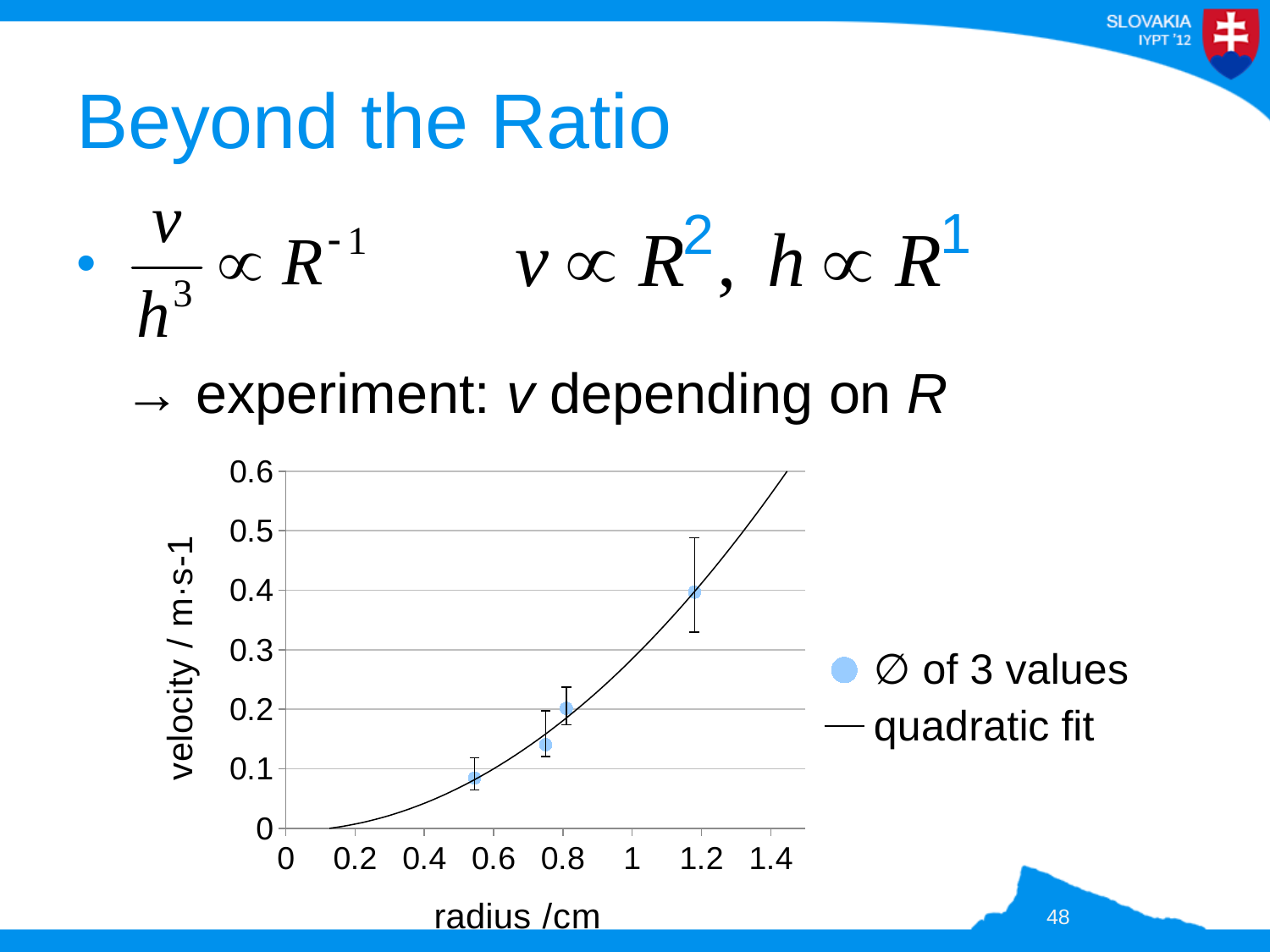
Which data point has the highest velocity: the one with the smallest radius or the one with the largest radius? the one with the largest radius How many entries does the chart's legend list? 2 Does velocity rise or fall as radius increases along the x axis? rise What is the highest value shown on the y axis of the chart? 0.6 What is the label of the y axis of the chart? velocity / m·s-1 What is the label of the x axis of the chart? radius /cm Is the velocity of the data point with the largest radius greater or less than 0.3? greater How many data points are plotted in the chart? 4 What kind of chart is shown on the slide? scatter plot Is the velocity of the data point at a radius of about 0.75 cm greater or less than 0.2? less Is the velocity of the data point with the smallest radius greater or less than 0.1? less